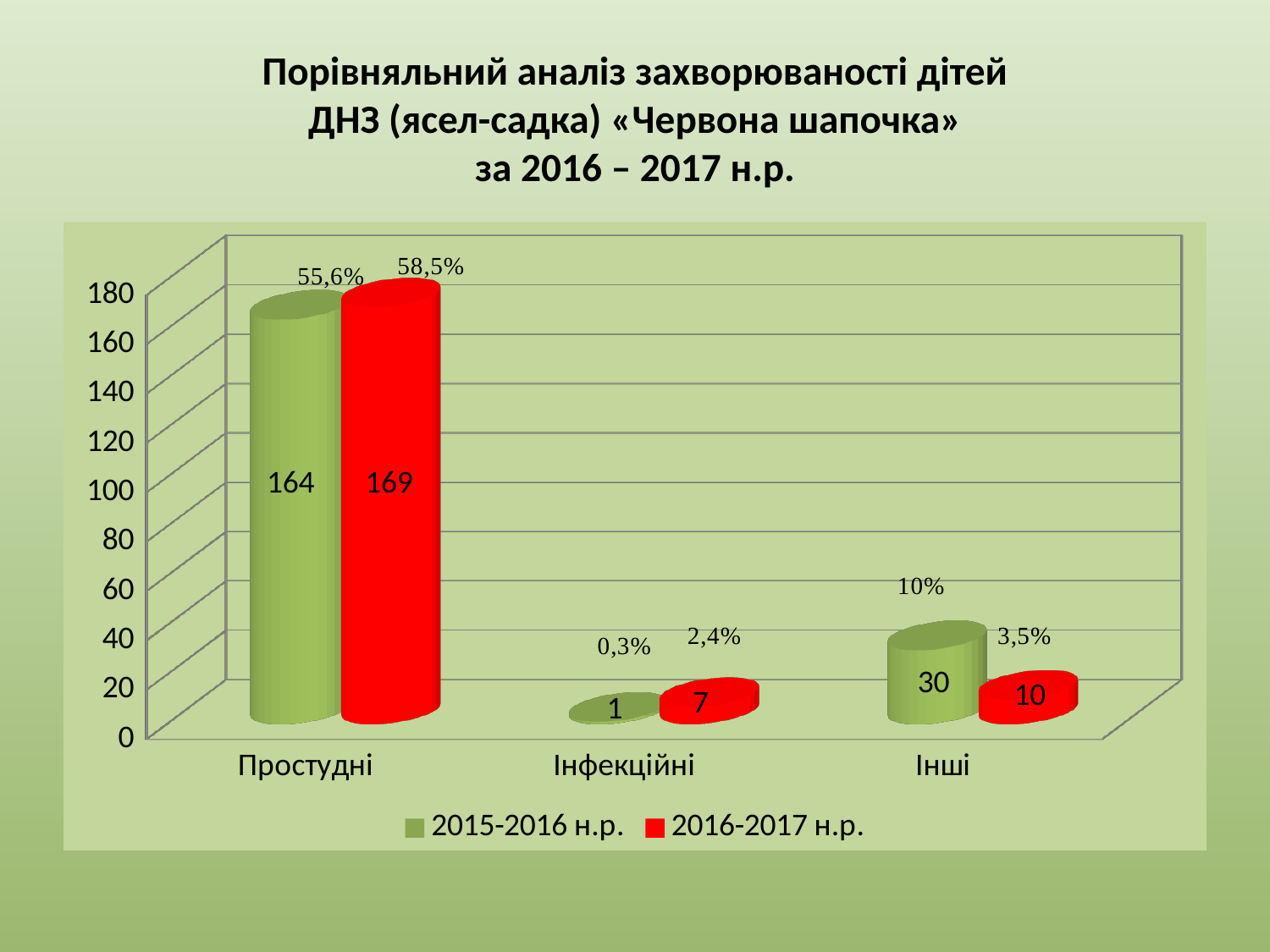
What is the value for Інші in the 2015-2016 н.р. series? 30 What is the value for Простудні in the 2015-2016 н.р. series? 164 What kind of chart is shown on the slide? Bar chart What is the value for Інфекційні in the 2016-2017 н.р. series? 7 Which category has the lowest value in the 2015-2016 н.р. series? Інфекційні How many categories are shown on the x axis? 3 What percentage label is shown above the 2016-2017 н.р. bar for Простудні? 58,5% For Інші, which series has the larger value, 2015-2016 н.р. or 2016-2017 н.р.? 2015-2016 н.р. How many series does the legend list? 2 Which category has the highest value in the 2016-2017 н.р. series? Простудні What is the value for Простудні in the 2016-2017 н.р. series? 169 What is the difference between the 2016-2017 н.р. and 2015-2016 н.р. values for Простудні? 5